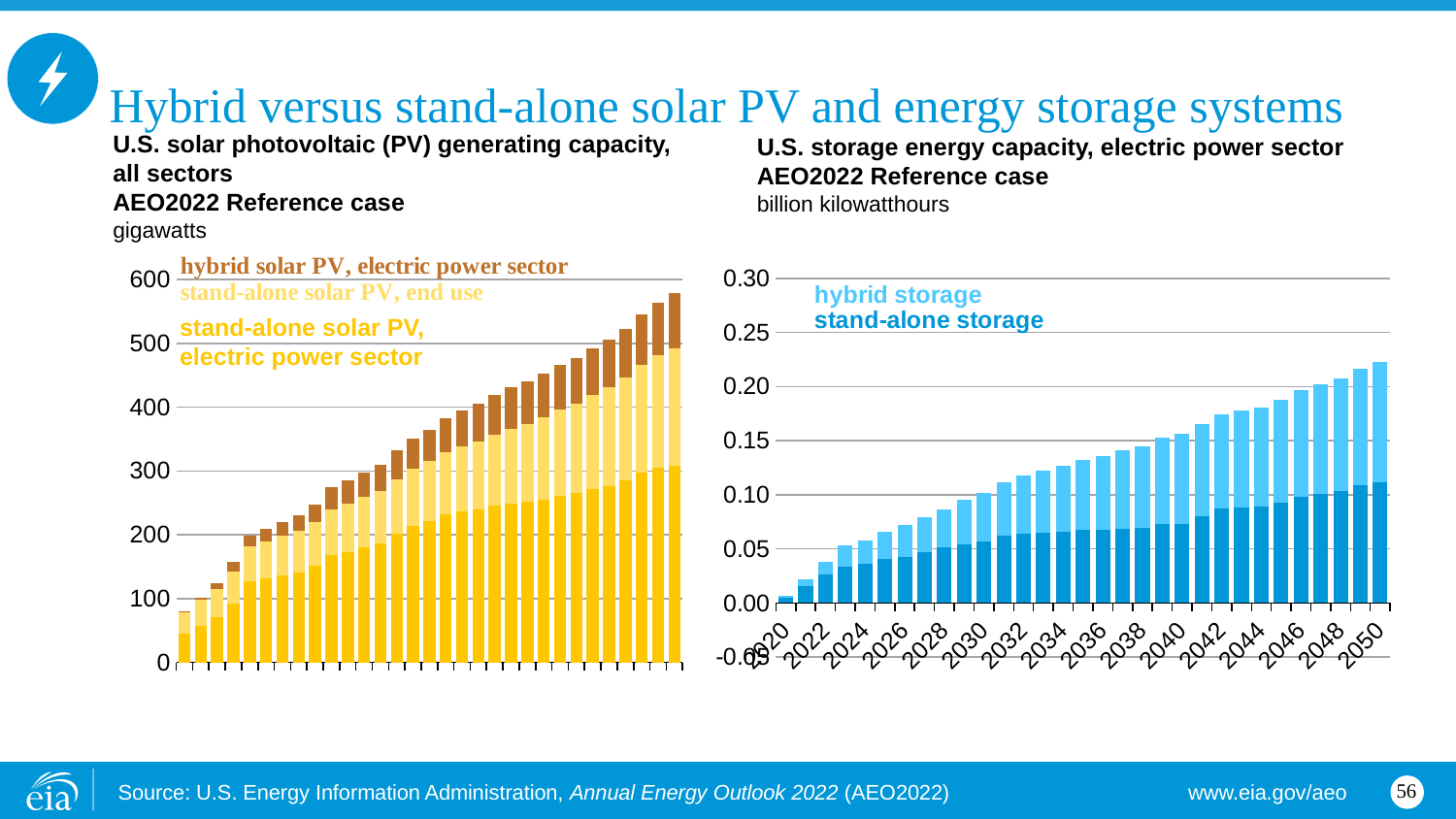
What unit is used on the right chart (U.S. storage energy capacity)? billion kilowatthours In the right chart (U.S. storage energy capacity), is the total value for 2026 greater or less than 0.05? greater What kind of chart is the left chart, 'U.S. solar photovoltaic (PV) generating capacity, all sectors'? stacked bar chart How many series does the legend of the right chart (U.S. storage energy capacity) list? 2 What unit is used on the left chart (U.S. solar PV generating capacity)? gigawatts In the left chart (U.S. solar PV generating capacity), is the total of the rightmost bar greater or less than 500? greater In the right chart (U.S. storage energy capacity), is the total value for 2050 greater or less than 0.20? greater In the right chart (U.S. storage energy capacity), do the total values rise or fall from 2020 to 2050? rise How many series does the legend of the left chart (U.S. solar PV generating capacity) list? 3 In the left chart (U.S. solar PV generating capacity), do the total values rise or fall along the x axis? rise